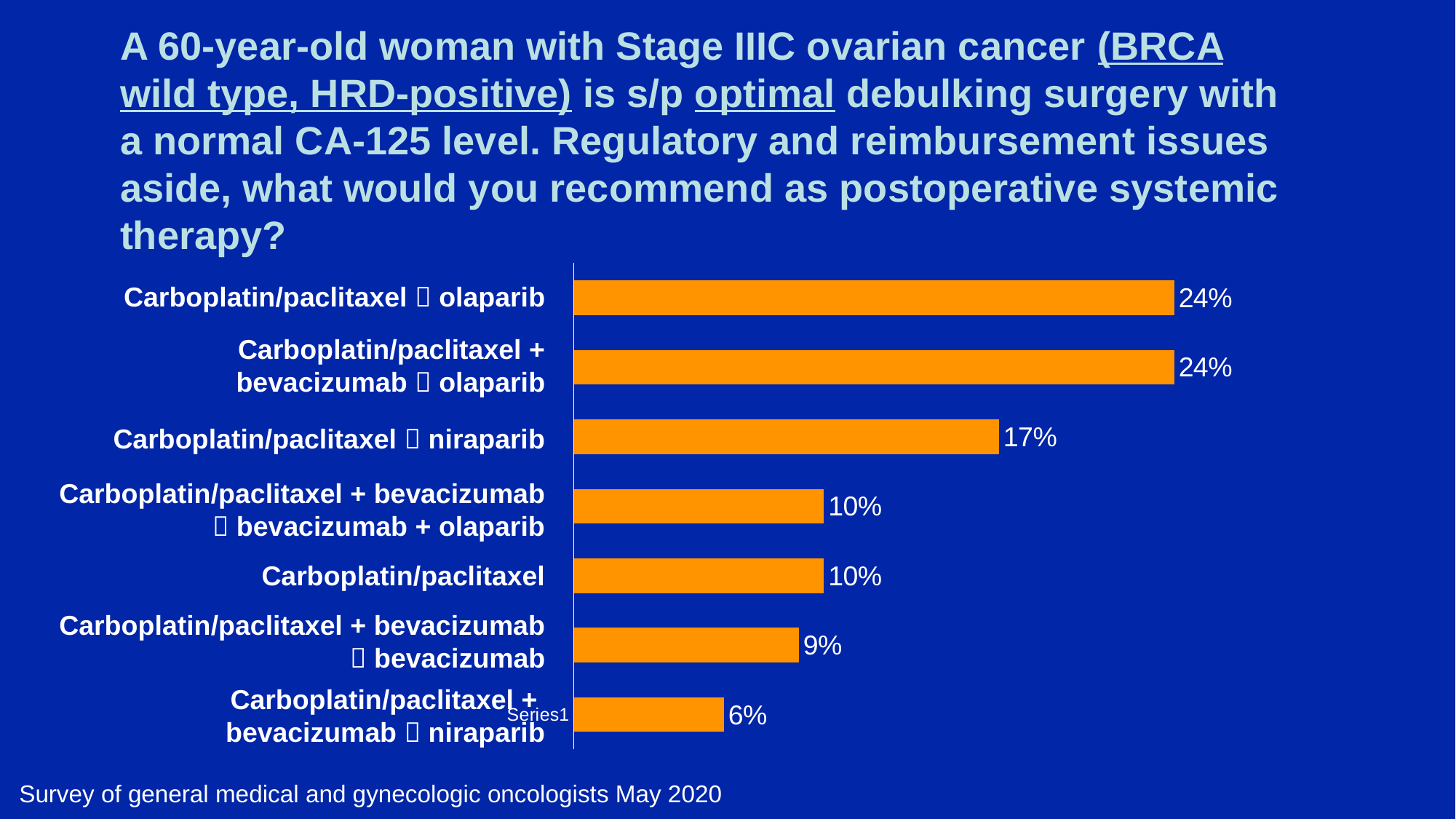
What is the value shown for Carboplatin/paclitaxel + bevacizumab → bevacizumab? 9% What is the difference between the value for Carboplatin/paclitaxel and the value for Carboplatin/paclitaxel + bevacizumab → niraparib? 4 percentage points What percentage of respondents chose Carboplatin/paclitaxel → niraparib? 17% How many percentage points higher is Carboplatin/paclitaxel → olaparib than Carboplatin/paclitaxel → niraparib? 7 percentage points How many treatment options are shown in the chart? 7 What is the value shown for Carboplatin/paclitaxel + bevacizumab → olaparib? 24% Which option received the lowest percentage of responses? Carboplatin/paclitaxel + bevacizumab → niraparib What colour are the bars in the chart? Orange What percentage of respondents chose Carboplatin/paclitaxel alone? 10% Which received a larger share of responses: Carboplatin/paclitaxel → niraparib or Carboplatin/paclitaxel alone? Carboplatin/paclitaxel → niraparib What type of chart is shown on the slide? Bar chart Which two options tie for the highest percentage of responses? Carboplatin/paclitaxel → olaparib and Carboplatin/paclitaxel + bevacizumab → olaparib